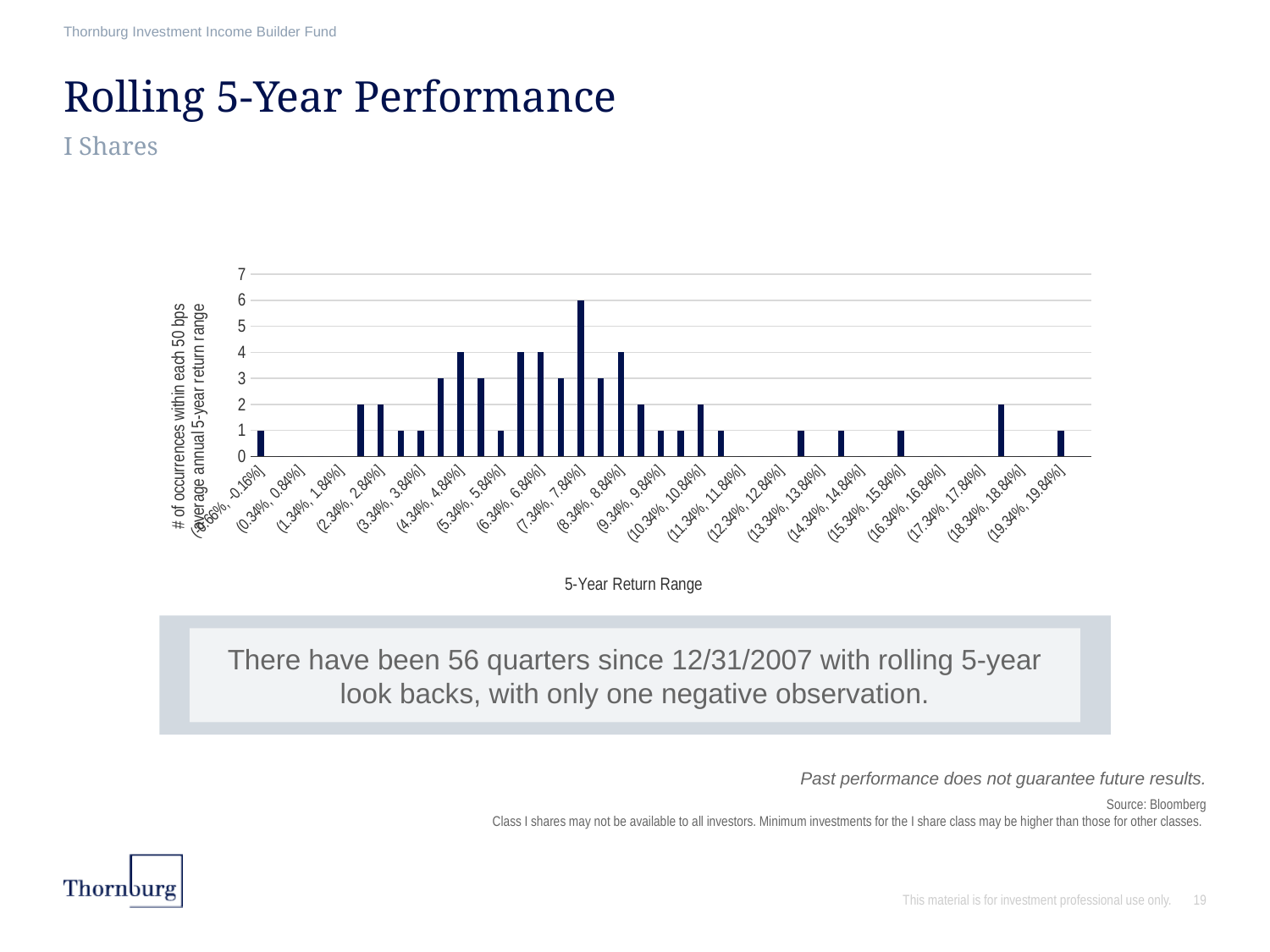
Which return range has more occurrences, (4.34%, 4.84%] or (5.34%, 5.84%]? (4.34%, 4.84%] What is the highest tick value shown on the y axis? 7 What is the highest number of occurrences shown for any return range? 6 What is the title of the x axis of the chart? 5-Year Return Range How many occurrences are shown for the (-0.66%, -0.16%] return range? 1 What kind of chart is shown on the slide? bar chart How many more occurrences does the (7.34%, 7.84%] range have than the (9.34%, 9.84%] range? 5 How many occurrences are shown for the (7.34%, 7.84%] return range? 6 How many occurrences are shown for the (4.34%, 4.84%] return range? 4 How many occurrences are shown for the (1.34%, 1.84%] return range? 0 How many occurrences are shown for the (19.34%, 19.84%] return range? 1 How many occurrences are shown for the (10.34%, 10.84%] return range? 2